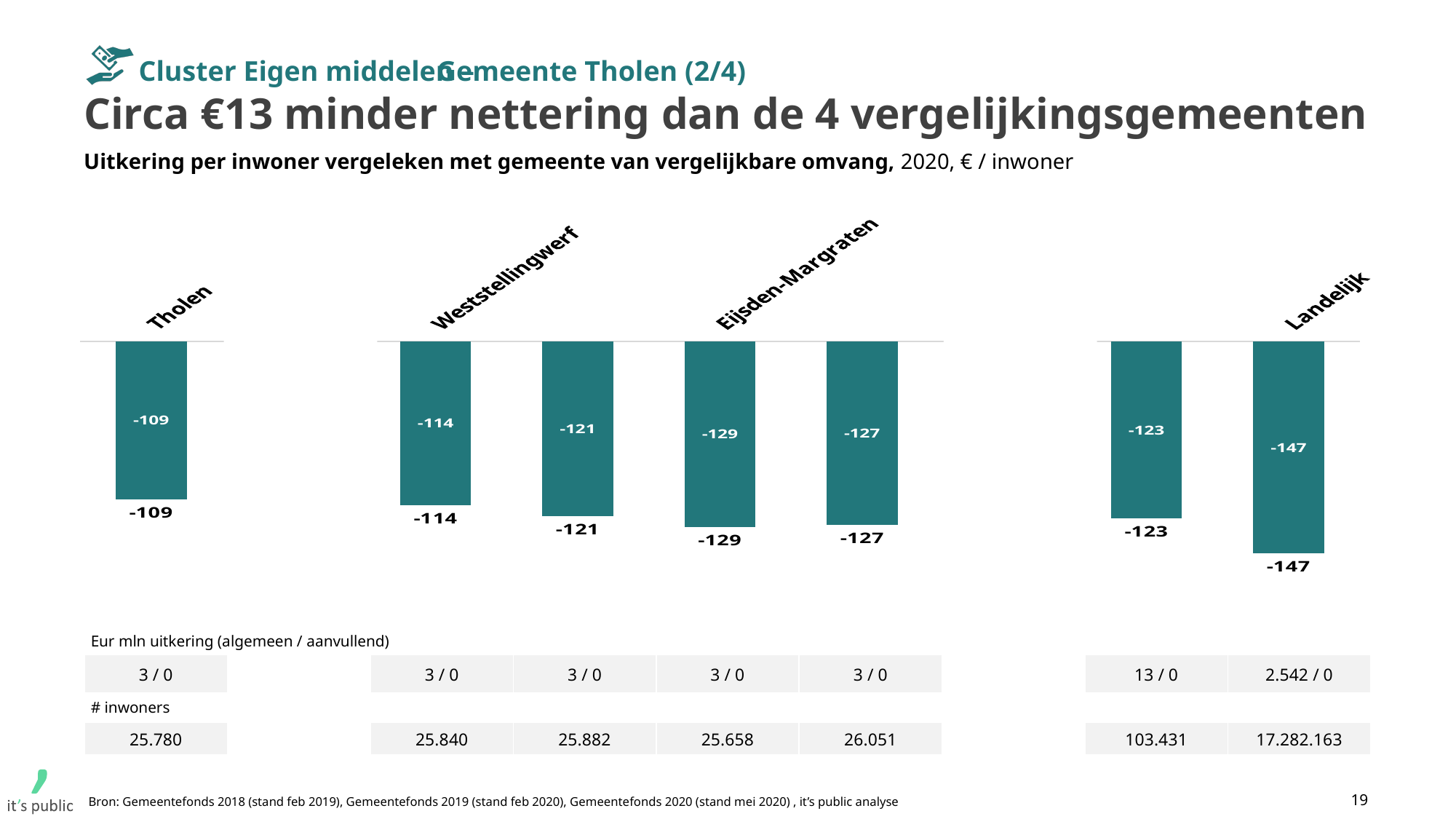
What is the value for Eijsden-Margraten? -129 What is the value for Weststellingwerf? -114 Which labelled category has the highest (least negative) value? Tholen What is the value for Landelijk? -147 What is the difference between the values for Tholen and Landelijk? 38 How many bars are plotted in the chart? 7 Which is larger, the value for Tholen or the value for Weststellingwerf? Tholen What kind of chart is shown on the slide? Bar chart What is the value for Tholen? -109 Which labelled category has the lowest (most negative) value? Landelijk What is the difference between the values for Eijsden-Margraten and Tholen? 20 What is the unit stated in the chart subtitle? € / inwoner